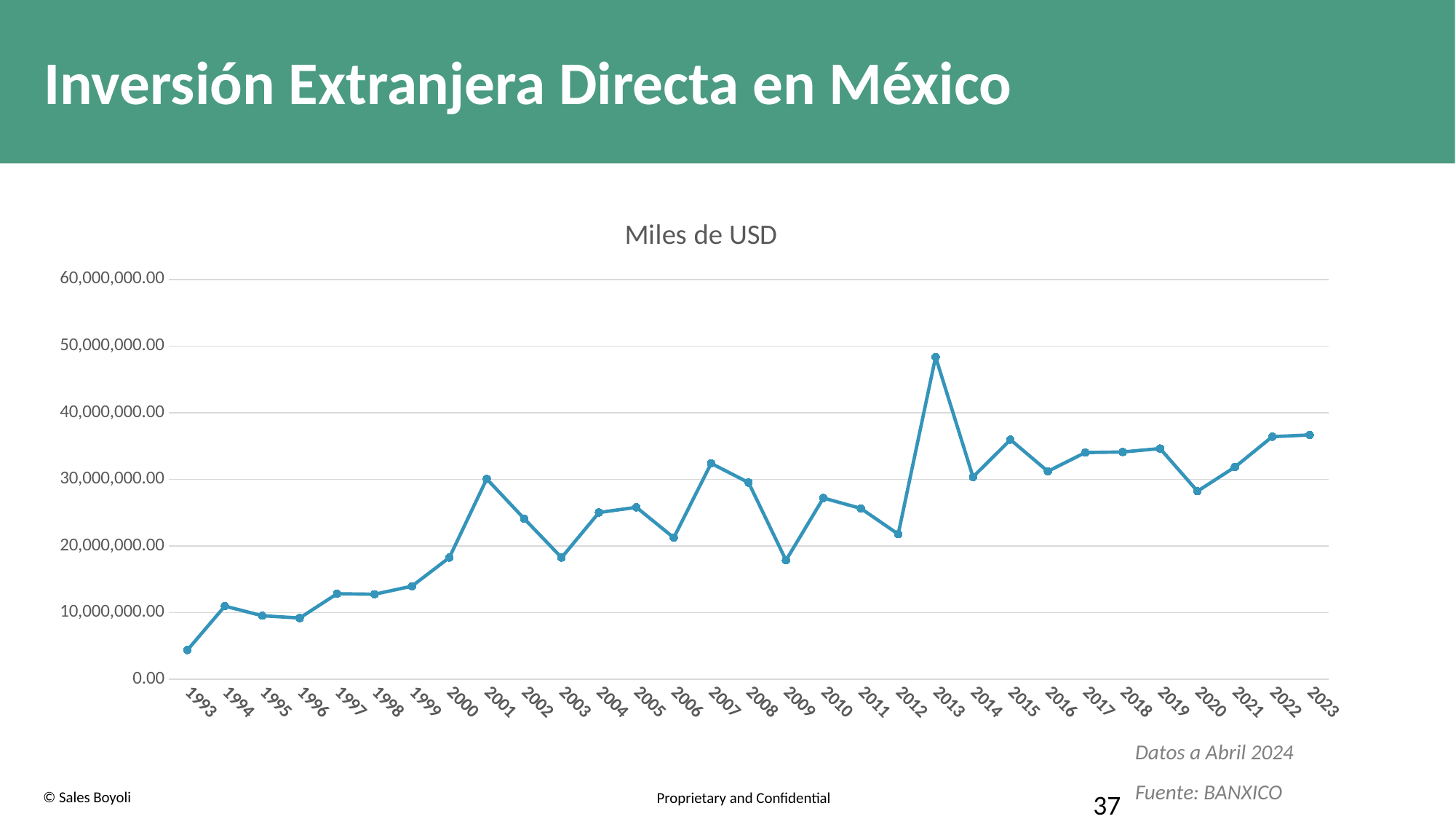
Is the value for 1993 greater or less than 10,000,000.00? less Do the values generally rise or fall from 1993 to 2001? rise Which is larger, the value for 2013 or the value for 2014? 2013 Is the value for 2015 greater or less than 30,000,000.00? greater How many years are plotted on the x axis of the chart? 31 Is the value for 2009 greater or less than 20,000,000.00? less What is the title shown above the chart? Miles de USD Which is larger, the value for 2007 or the value for 2009? 2007 Which year has the lowest value in the chart? 1993 Which year has the highest value in the chart? 2013 What kind of chart is shown on the slide? line chart